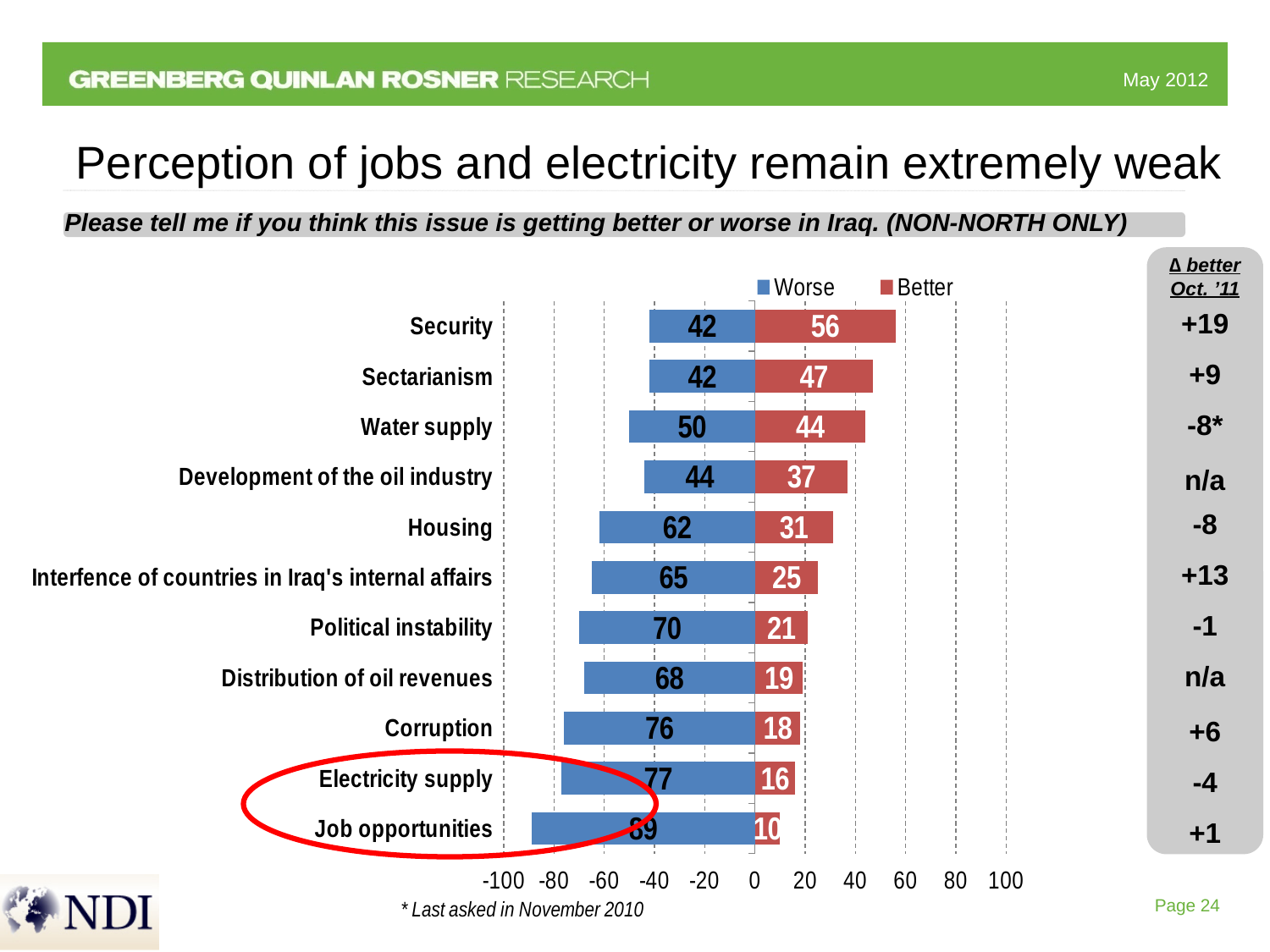
What percentage say security is getting better? 56 What is the 'Worse' value for Housing? 62 How many issues are listed on the chart? 11 What is the difference between the 'Worse' and 'Better' values for Corruption? 58 Which issue has the highest 'Better' value? Security How many series does the legend list? 2 Which issue has the lowest 'Better' value? Job opportunities Which is larger for Water supply, the 'Worse' value or the 'Better' value? Worse Which colour represents the 'Worse' series in the chart? Blue What is the 'Better' value for Political instability? 21 What is the 'Better' value for Electricity supply? 16 What kind of chart is shown on the slide? Bar chart